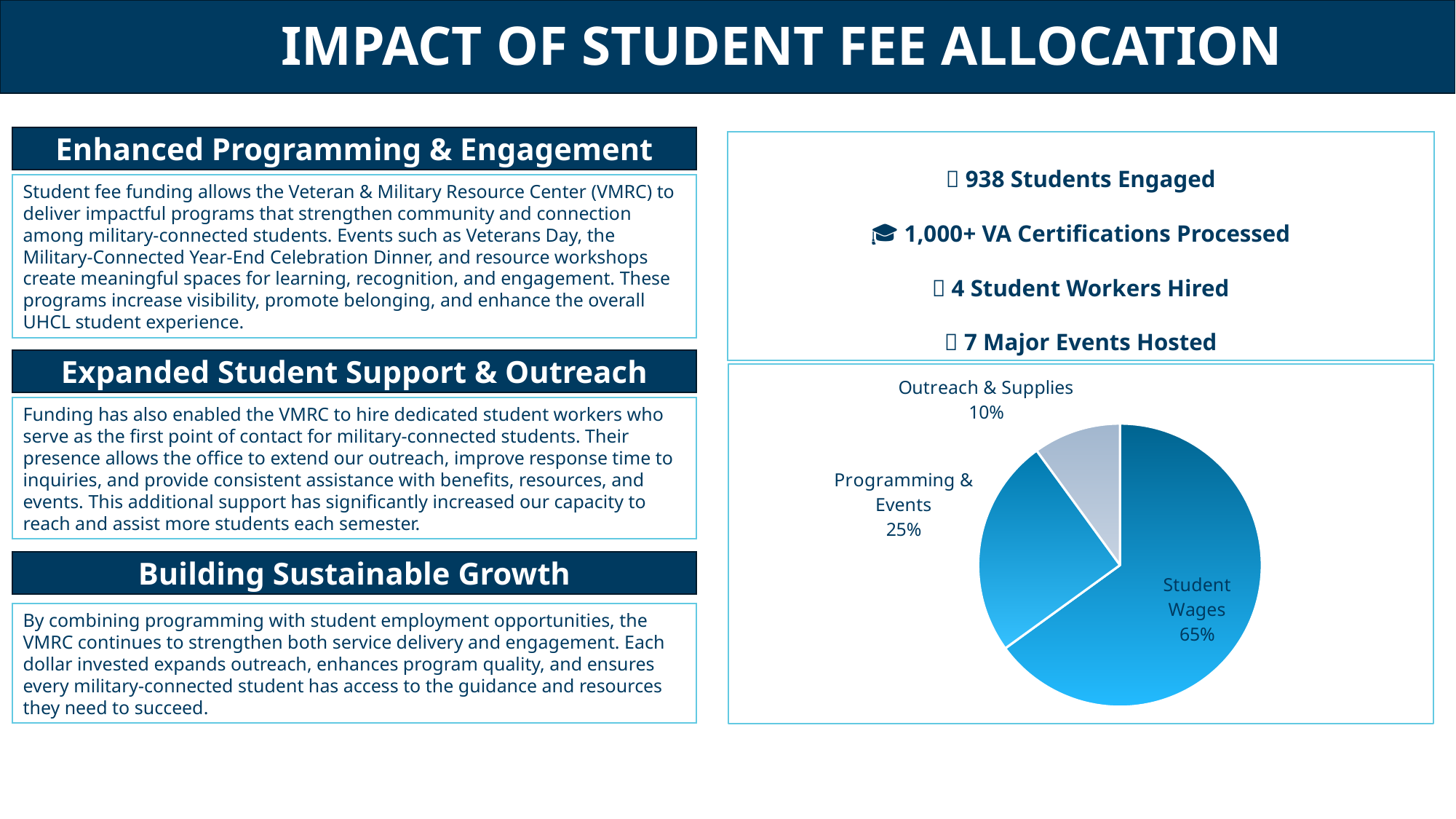
What share of the pie does Outreach & Supplies represent? 10% Which slice of the pie chart is shown in light grey-blue? Outreach & Supplies What kind of chart is shown on the slide? pie chart What is the difference in percentage points between Programming & Events and Outreach & Supplies? 15 Which slice of the pie chart is the smallest? Outreach & Supplies Is the share for Student Wages greater or less than 50%? greater What share of the pie does Programming & Events represent? 25% How many slices does the pie chart have? 3 What share of the pie does Student Wages represent? 65% Which is larger in the pie chart, Programming & Events or Outreach & Supplies? Programming & Events What is the difference in percentage points between Student Wages and Programming & Events? 40 Which slice of the pie chart is the largest? Student Wages